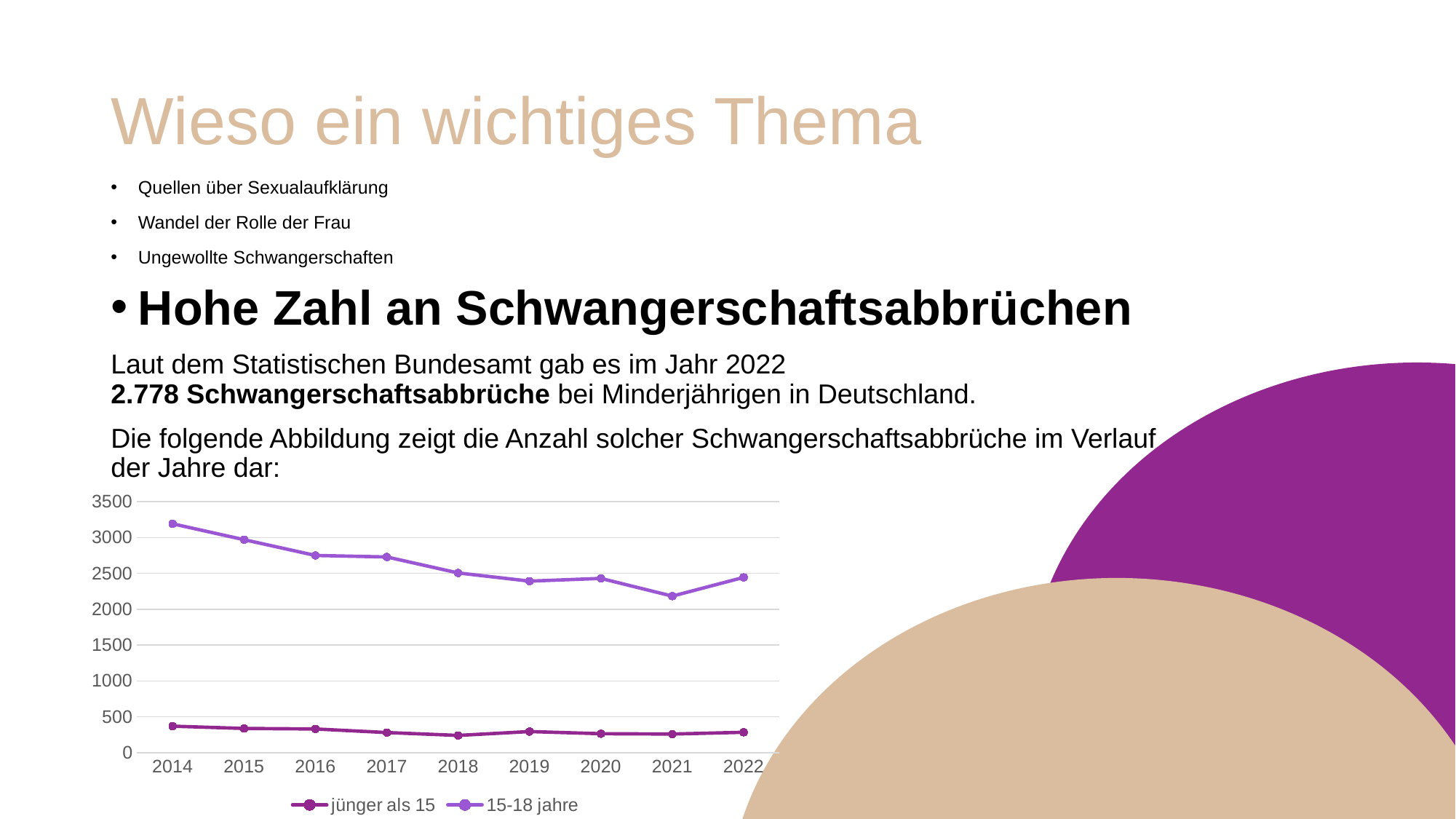
In which year is the value for the 15-18 jahre series highest? 2014 Which series has higher values throughout the chart, jünger als 15 or 15-18 jahre? 15-18 jahre Is the value for 15-18 jahre in 2021 greater or less than 2500? less In which year is the value for the 15-18 jahre series lowest? 2021 Is the value for 15-18 jahre in 2014 greater or less than 3000? greater Does the 15-18 jahre series generally rise or fall from 2014 to 2022? fall Is the value for jünger als 15 in 2018 greater or less than 500? less How many series does the chart legend list? 2 Which is larger for the 15-18 jahre series: the value in 2014 or the value in 2022? 2014 How many years are plotted along the x axis of the chart? 9 What kind of chart is shown on the slide? line chart Which two series are listed in the chart legend? jünger als 15 and 15-18 jahre